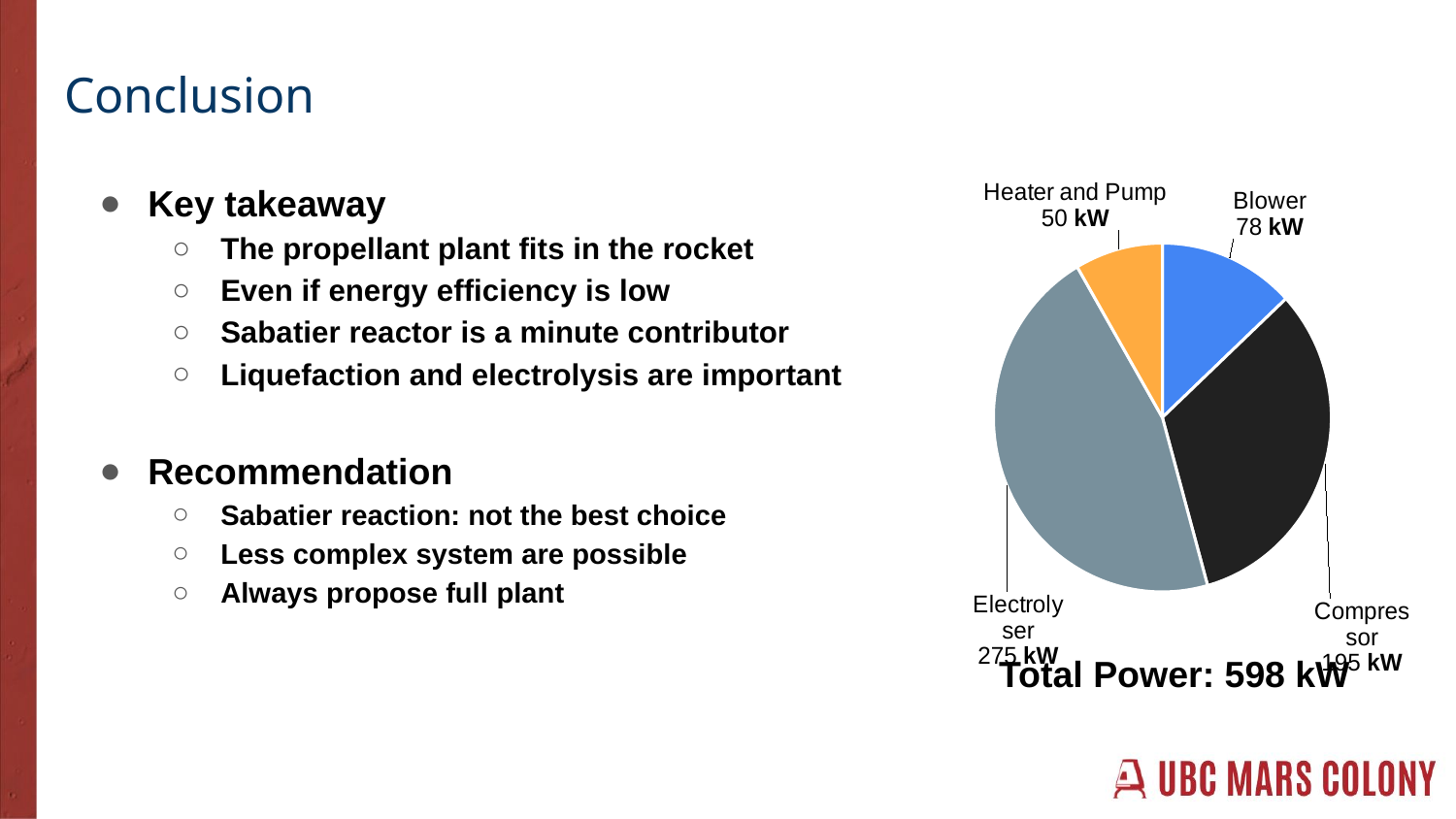
What is the power value shown for the Compressor slice? 195 kW What is the difference in power between the Blower and the Heater and Pump? 28 kW What is the total power stated below the pie chart? 598 kW What is the power value shown for the Blower slice of the pie chart? 78 kW Which component has the smallest slice of the pie chart? Heater and Pump What kind of chart is shown on the slide? Pie chart Which uses more power, the Compressor or the Blower? Compressor How much more power does the Electrolyser use than the Compressor? 80 kW How many slices does the pie chart have? 4 What is the power value shown for the Electrolyser slice? 275 kW Which component has the largest slice of the pie chart? Electrolyser What is the power value shown for Heater and Pump in the pie chart? 50 kW